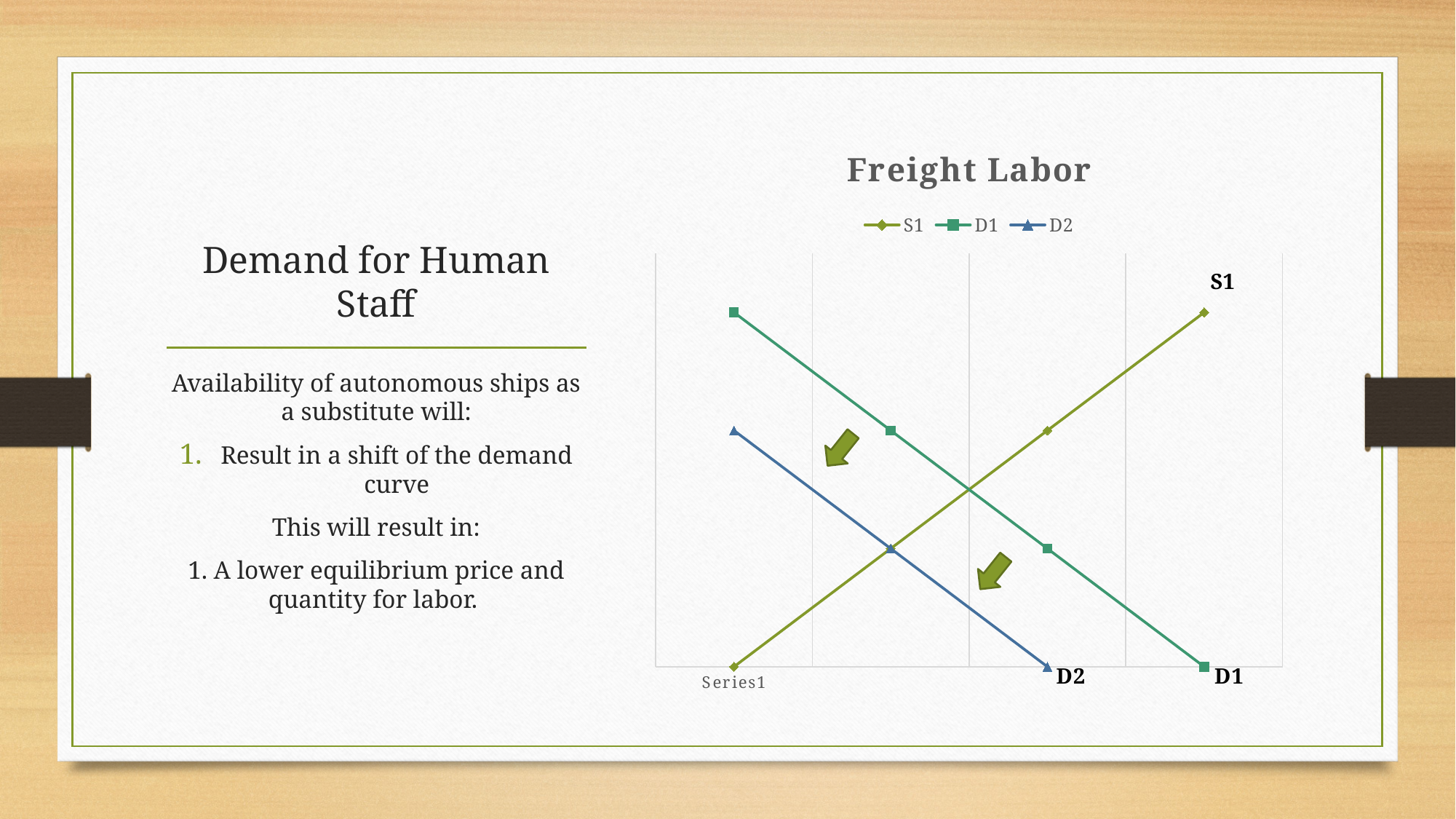
How many series does the chart's legend list? 3 Does the D1 line rise or fall from left to right? Falls Does the D2 line rise or fall from left to right? Falls What is the title of the chart? Freight Labor How many data points are plotted on the S1 line? 4 Which series has the lowest value at the leftmost point? S1 Which series has the highest value at the rightmost point of the chart? S1 Does the S1 line rise or fall from left to right? Rises What kind of chart is shown on the slide? Line chart What are the series names listed in the chart's legend? S1, D1, D2 At the leftmost point, which line is higher, D1 or D2? D1 How many data points are plotted on the D2 line? 3